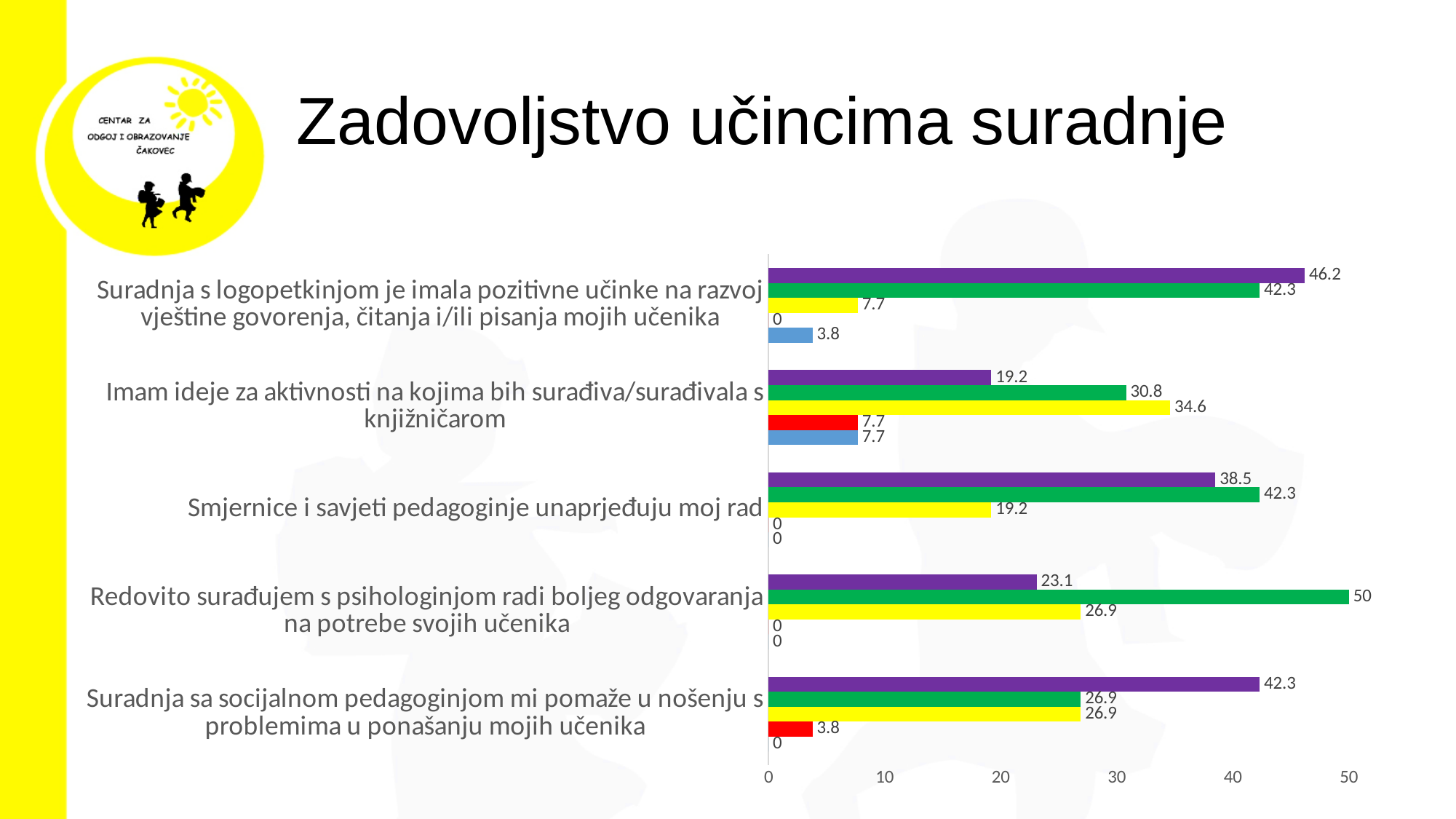
What is the value of the purple bar for "Suradnja s logopetkinjom je imala pozitivne učinke na razvoj vještine govorenja, čitanja i/ili pisanja mojih učenika"? 46.2 What kind of chart is shown on the slide? bar chart What is the value of the green bar for "Redovito surađujem s psihologinjom radi boljeg odgovaranja na potrebe svojih učenika"? 50 Is the purple bar for "Smjernice i savjeti pedagoginje unaprjeđuju moj rad" greater or less than 30? greater Which category has the highest green bar? Redovito surađujem s psihologinjom radi boljeg odgovaranja na potrebe svojih učenika How many categories are shown on the chart? 5 How many bars (series) are shown for each category? 5 What is the difference between the purple bar and the green bar for "Suradnja sa socijalnom pedagoginjom mi pomaže u nošenju s problemima u ponašanju mojih učenika"? 15.4 Which category has the lowest purple bar? Imam ideje za aktivnosti na kojima bih surađiva/surađivala s knjižničarom What is the title of the slide? Zadovoljstvo učincima suradnje For "Smjernice i savjeti pedagoginje unaprjeđuju moj rad", which is larger: the purple bar or the green bar? the green bar What is the value of the yellow bar for "Imam ideje za aktivnosti na kojima bih surađiva/surađivala s knjižničarom"? 34.6